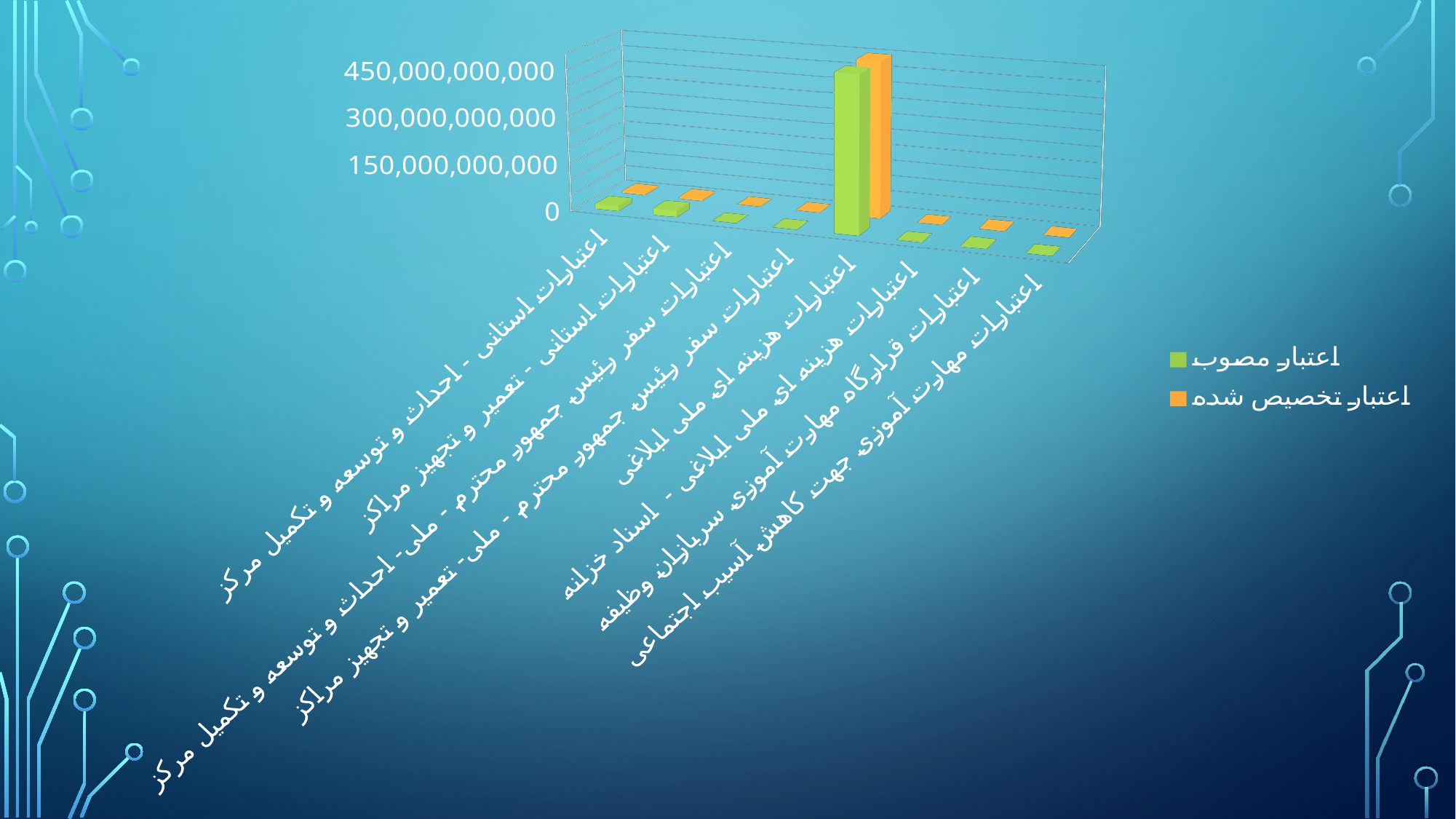
What colour represents the اعتبار تخصیص شده series? orange What are the two series named in the legend? اعتبار مصوب and اعتبار تخصیص شده Is the اعتبار تخصیص شده value for اعتبارات مهارت آموزی جهت کاهش آسیب اجتماعی greater or less than 150,000,000,000? less Is the اعتبار مصوب value for اعتبارات استانی - تعمیر و تجهیز مراکز greater or less than 150,000,000,000? less How many series does the legend list? 2 Which is larger: the اعتبار مصوب value for اعتبارات هزینه ای ملی ابلاغی or for اعتبارات قرارگاه مهارت آموزی سربازان وظیفه? اعتبارات هزینه ای ملی ابلاغی Which category has the highest value for اعتبار مصوب? اعتبارات هزینه ای ملی ابلاغی Which category has the highest value for اعتبار تخصیص شده? اعتبارات هزینه ای ملی ابلاغی How many categories are plotted along the x axis? 8 Is the اعتبار مصوب value for اعتبارات هزینه ای ملی ابلاغی greater or less than 300,000,000,000? greater What kind of chart is shown on the slide? bar chart